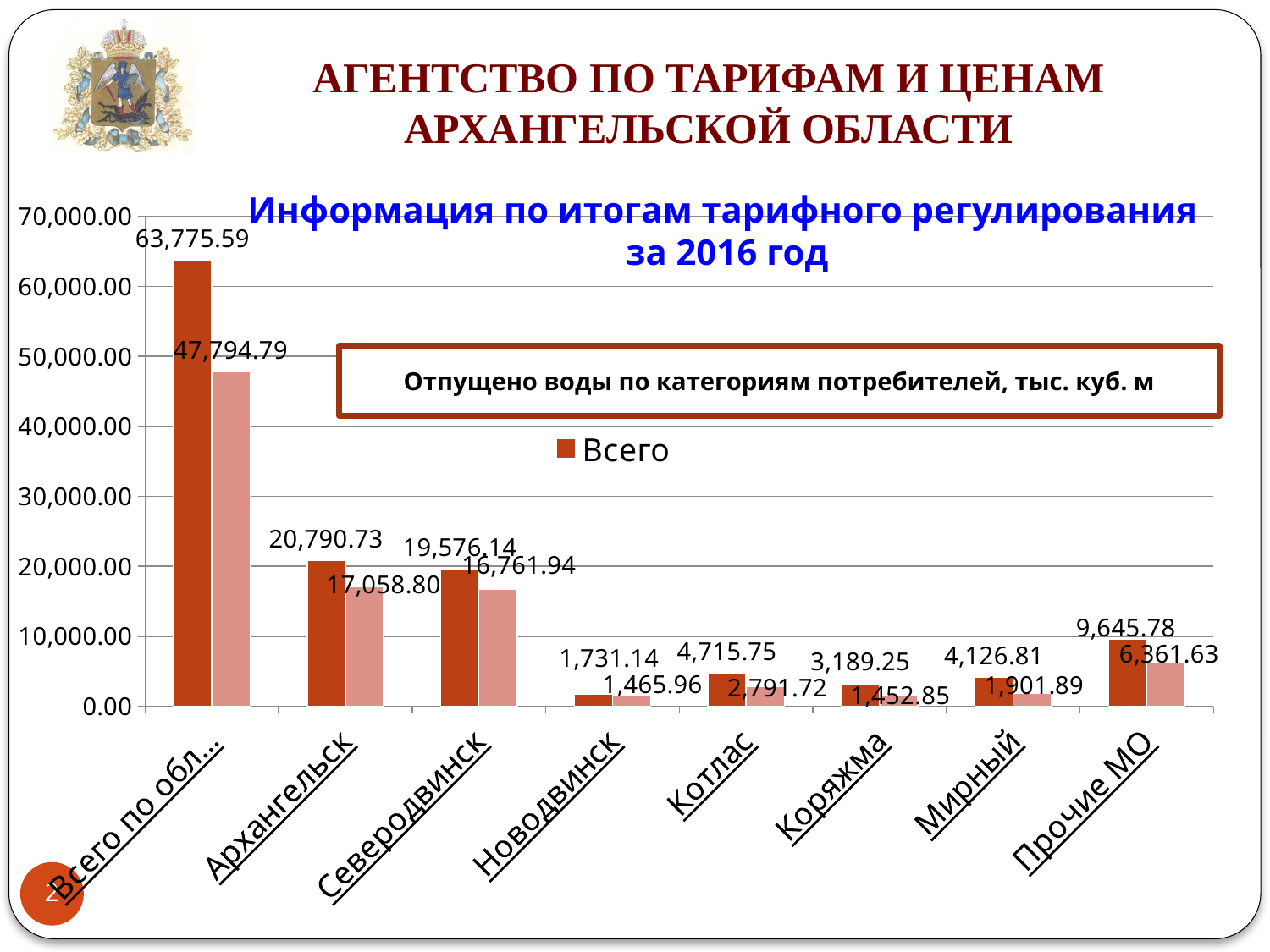
What kind of chart is shown on the slide? bar chart What is the text in the boxed label above the chart? Отпущено воды по категориям потребителей, тыс. куб. м What is the 'Всего' value for Прочие МО? 9,645.78 What is the 'Всего' value for Коряжма? 3,189.25 Is the 'Всего' value for Прочие МО greater or less than 10,000.00? less What is the difference between the 'Всего' values for Котлас and Мирный? 588.94 How many categories are shown on the x axis? 8 What is the 'Всего' value for Архангельск? 20,790.73 Which category has the highest 'Всего' value? Всего по обл... Which has a larger 'Всего' value, Архангельск or Северодвинск? Архангельск Which category has the lowest 'Всего' value? Новодвинск What is the 'Всего' value for Северодвинск? 19,576.14